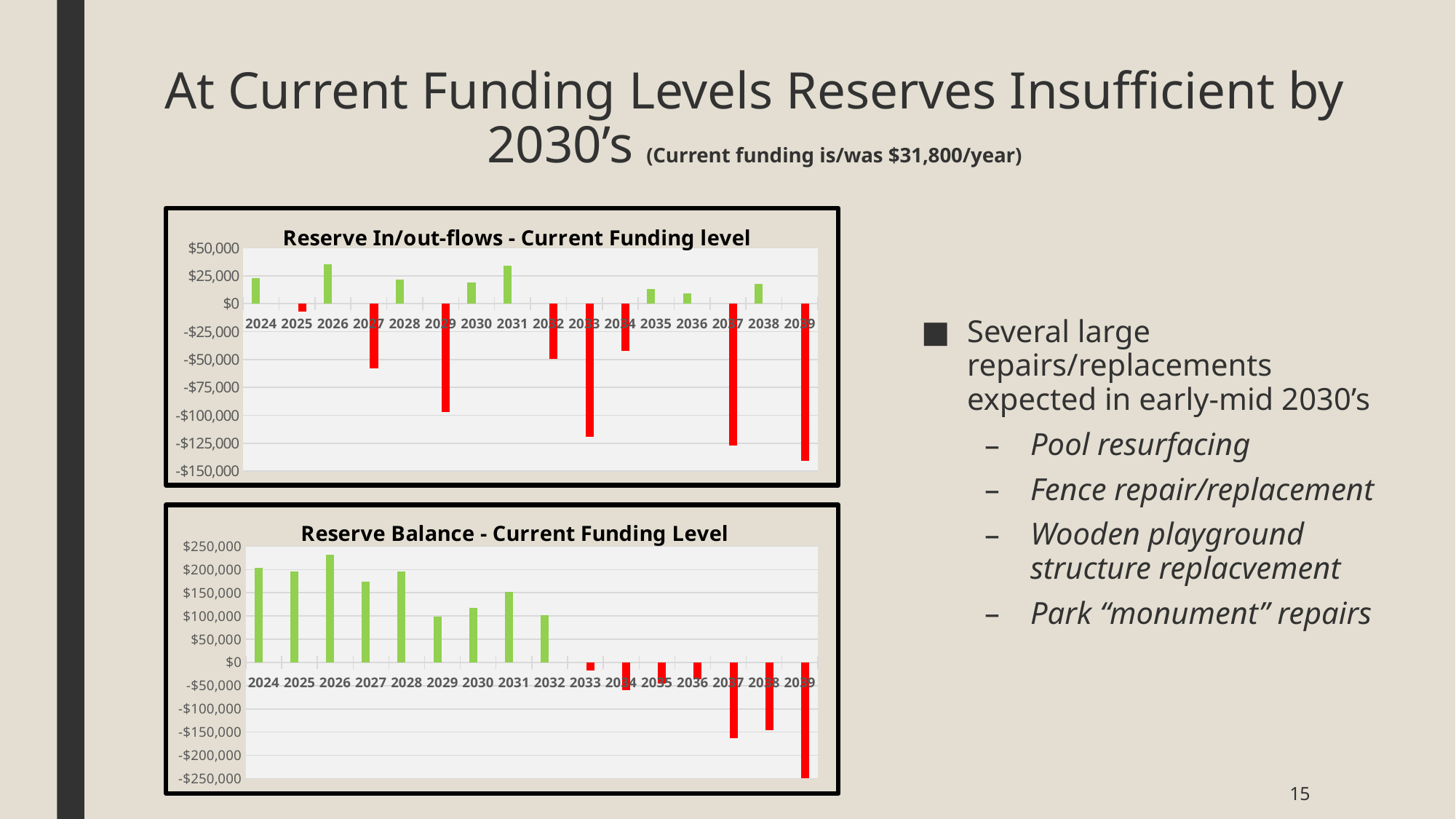
In the 'Reserve Balance - Current Funding Level' chart, which year has the highest balance? 2026 In the 'Reserve Balance - Current Funding Level' chart, is the value for 2039 greater or less than -$200,000? less In the 'Reserve In/out-flows - Current Funding level' chart, which year has the lowest value? 2039 In the 'Reserve In/out-flows - Current Funding level' chart, which is larger, the value for 2026 or the value for 2027? 2026 In the 'Reserve Balance - Current Funding Level' chart, what colour are the bars for years with a negative balance? red In the 'Reserve Balance - Current Funding Level' chart, is the value for 2031 greater or less than $100,000? greater How many years are shown on the x axis of the 'Reserve In/out-flows - Current Funding level' chart? 16 What type of chart is the 'Reserve In/out-flows - Current Funding level' chart? bar chart In the 'Reserve In/out-flows - Current Funding level' chart, is the value for 2033 greater or less than -$100,000? less In the 'Reserve Balance - Current Funding Level' chart, which year has the lowest balance? 2039 In the 'Reserve Balance - Current Funding Level' chart, does the reserve balance generally rise or fall from 2024 to 2039? fall